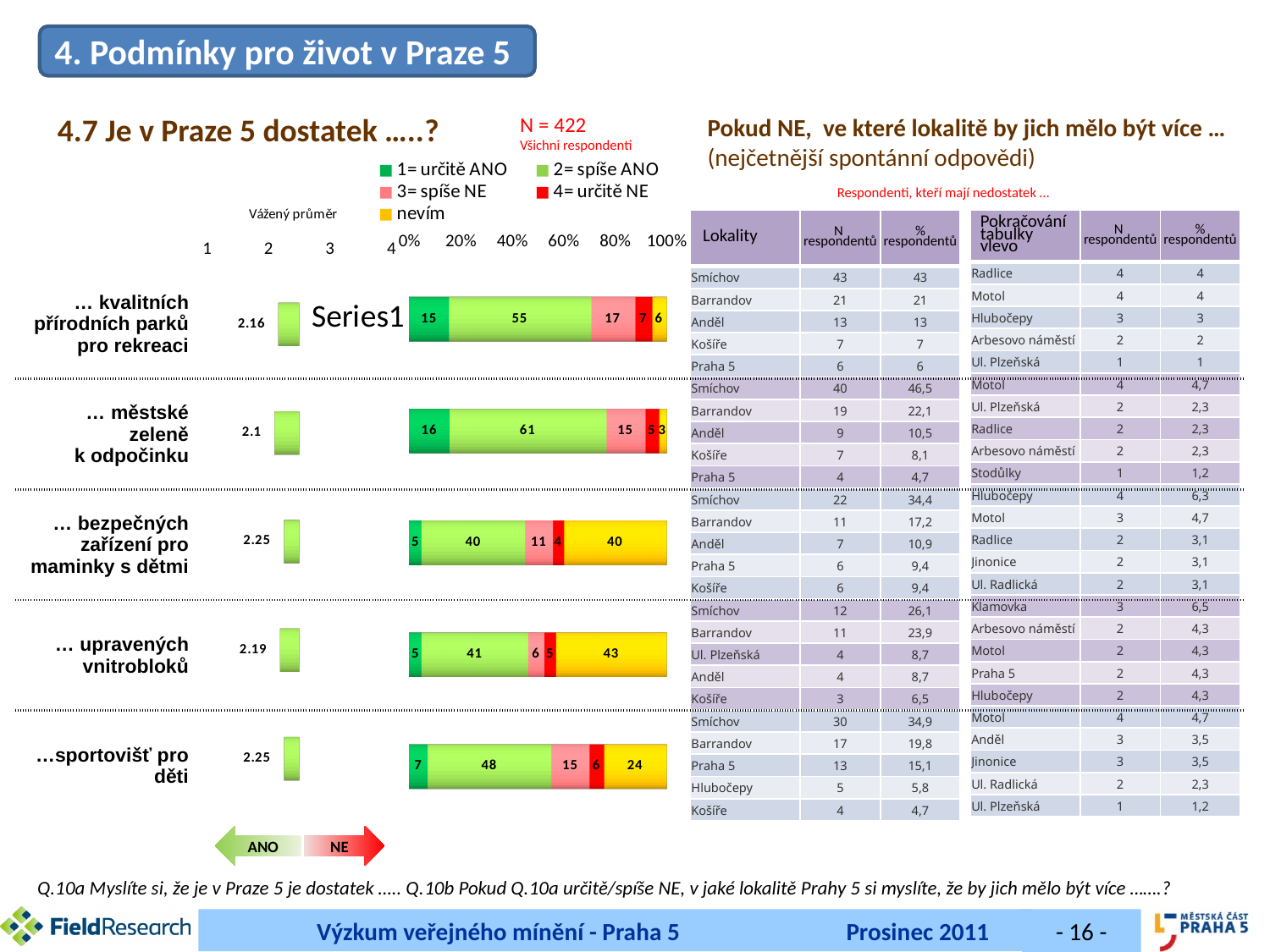
What is the weighted average (Vážený průměr) shown for '… městské zeleně k odpočinku'? 2.1 In the stacked bar chart for '… upravených vnitrobloků', what is the value for '2= spíše ANO'? 41 How many items (categories) are shown in the stacked bar charts? 5 Among the weighted averages (Vážený průměr) shown, which item has the lowest value? … městské zeleně k odpočinku In the stacked bar chart for '… kvalitních přírodních parků pro rekreaci', what is the difference between the '2= spíše ANO' value and the '3= spíše NE' value? 38 How many series does the legend of the stacked bar charts list? 5 In the stacked bar chart for '… bezpečných zařízení pro maminky s dětmi', what is the value for 'nevím'? 40 In the stacked bar chart for '… městské zeleně k odpočinku', what is the value for '1= určitě ANO'? 16 In the stacked bar chart for '…sportovišť pro děti', which is larger: the '2= spíše ANO' value or the 'nevím' value? 2= spíše ANO In the stacked bar chart for '…sportovišť pro děti', what is the value for '3= spíše NE'? 15 What type of chart is used to show the answer distribution for each item? Stacked bar chart In the stacked bar chart for '… kvalitních přírodních parků pro rekreaci', what percentage of respondents answered '2= spíše ANO'? 55